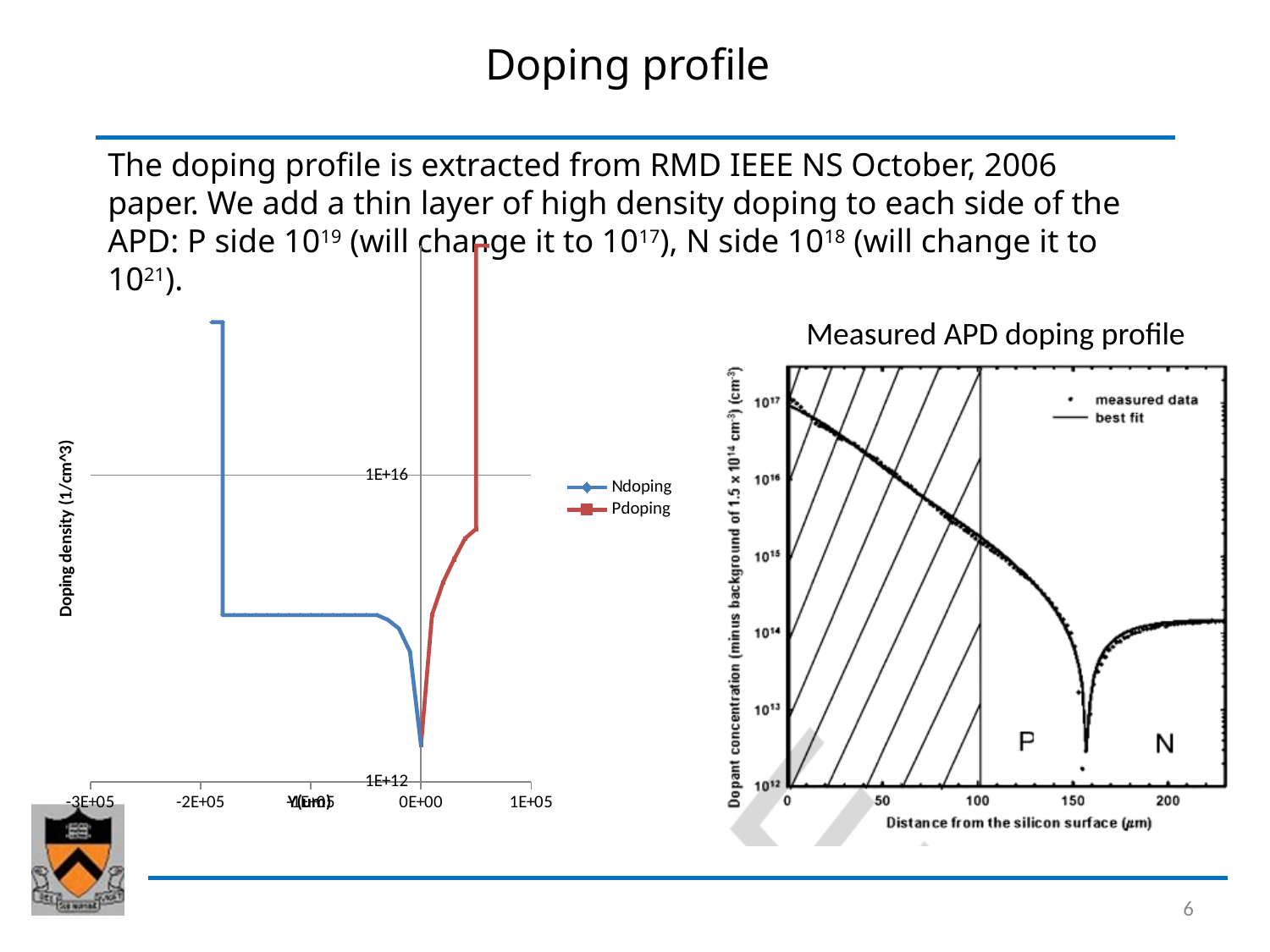
On the right chart titled 'Measured APD doping profile', is the dopant concentration at 50 μm greater or less than 10^15? greater On the right chart titled 'Measured APD doping profile', is the dopant concentration at 200 μm greater or less than 10^15? less What kind of chart is the left chart? line chart On the right chart titled 'Measured APD doping profile', how many entries does the legend list? 2 On the right chart titled 'Measured APD doping profile', does the dopant concentration rise or fall as distance increases from 0 to 150 μm? fall On the left chart, is the flat plateau value of the Ndoping series greater or less than 1E+16? less On the left chart, what is the label of the vertical axis? Doping density (1/cm^3) On the left chart, what are the names of the two series in the legend? Ndoping and Pdoping On the left chart, how many series does the legend list? 2 On the right chart titled 'Measured APD doping profile', what is the label of the horizontal axis? Distance from the silicon surface (μm)